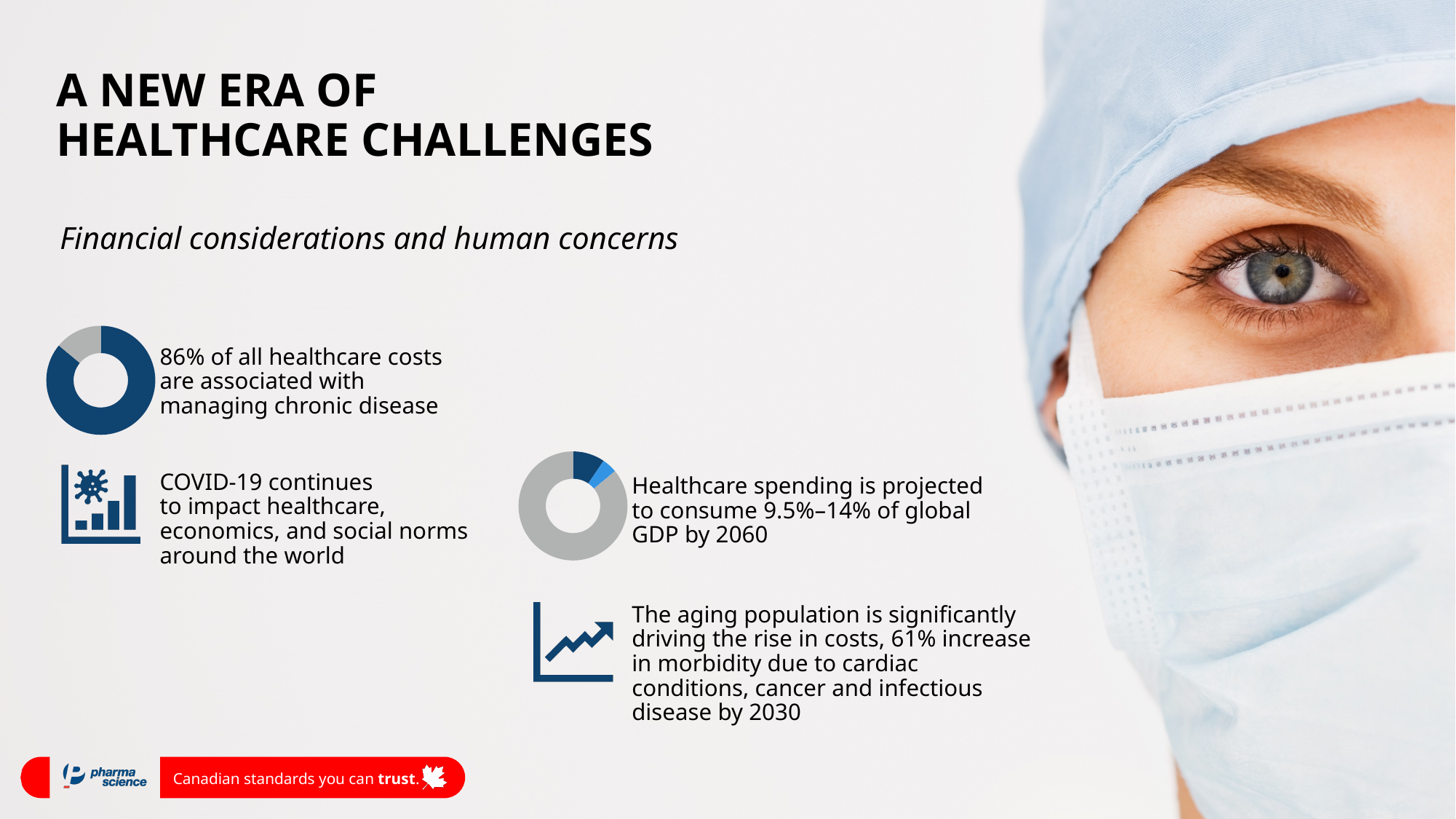
Which donut chart has the larger blue portion: the one about chronic disease costs or the one about healthcare spending as a share of GDP? The one about chronic disease costs How many distinct colours are used in the donut chart next to the healthcare spending text? 3 What colour is the 86% segment in the donut chart next to the chronic disease text? Dark blue What kind of chart is shown next to the text about chronic disease costs? Donut (pie) chart In the donut chart next to the healthcare spending text, what range of global GDP do the blue segments represent? 9.5%–14% In the donut chart next to the healthcare spending text, which colour fills the largest portion of the ring? Grey In the donut chart next to the healthcare spending text, by what year is spending projected to consume 9.5%–14% of global GDP? 2060 In the donut chart next to the chronic disease text, is the dark blue segment larger or smaller than the grey segment? Larger In the donut chart next to the chronic disease text, what share of healthcare costs does the dark blue segment represent? 86% How many donut charts appear on the slide? 2